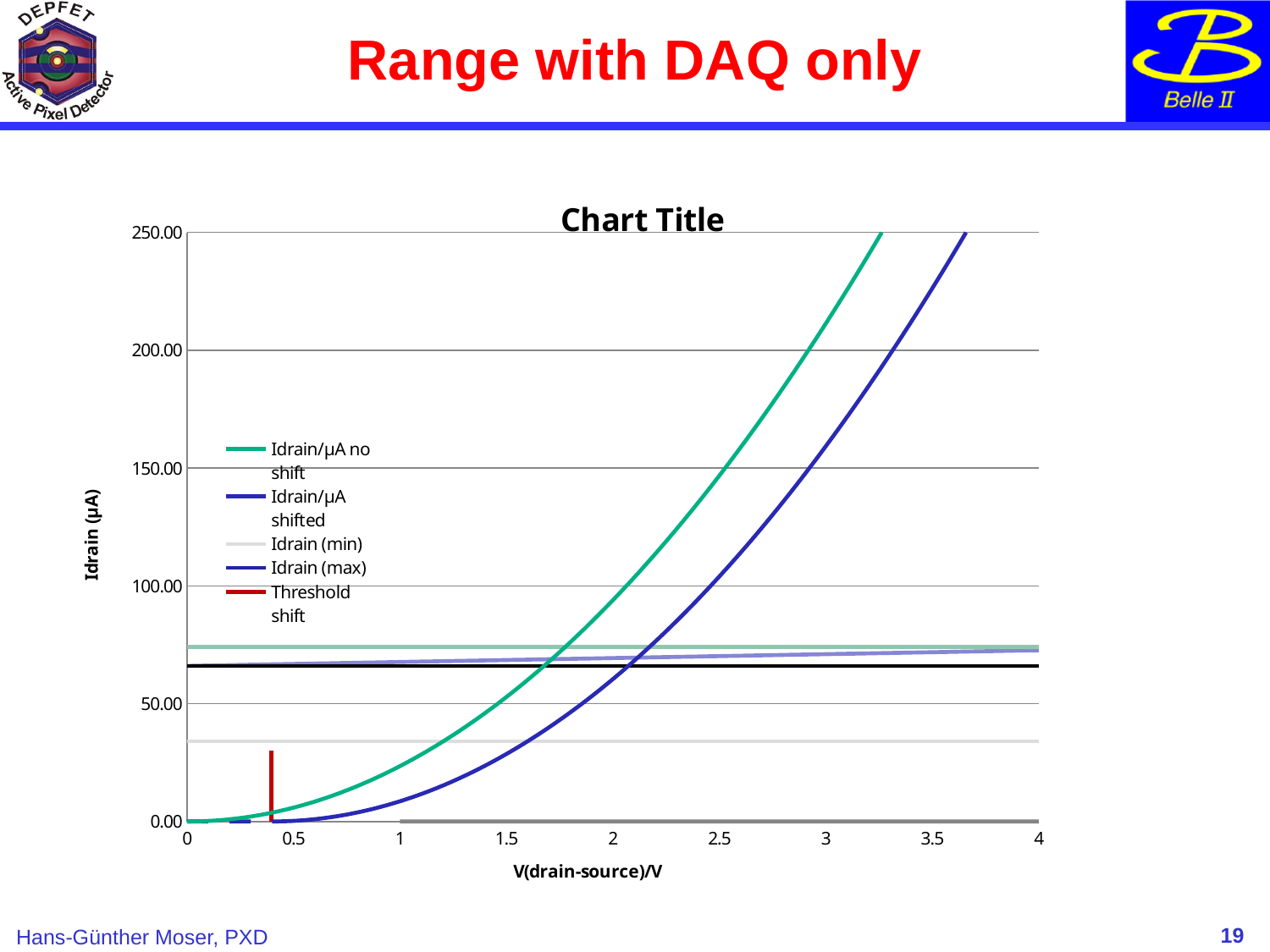
What is the title printed above the chart? Chart Title Is the value of the Idrain/µA shifted curve at V(drain-source) = 2 greater or less than 100? less What kind of chart is shown on the slide? line chart How many series does the chart legend list? 5 Is the value of the Idrain/µA no shift curve at V(drain-source) = 2.5 greater or less than 100? greater Does the Idrain/µA shifted curve rise or fall as V(drain-source) increases? rise At V(drain-source) = 2.5, which curve is higher: Idrain/µA no shift or Idrain/µA shifted? Idrain/µA no shift Does the Idrain/µA no shift curve rise or fall as V(drain-source) increases? rise What is the highest value shown on the y axis of the chart? 250.00 What is the label of the x axis of the chart? V(drain-source)/V Is the value of the Idrain/µA no shift curve at V(drain-source) = 1 greater or less than 50? less